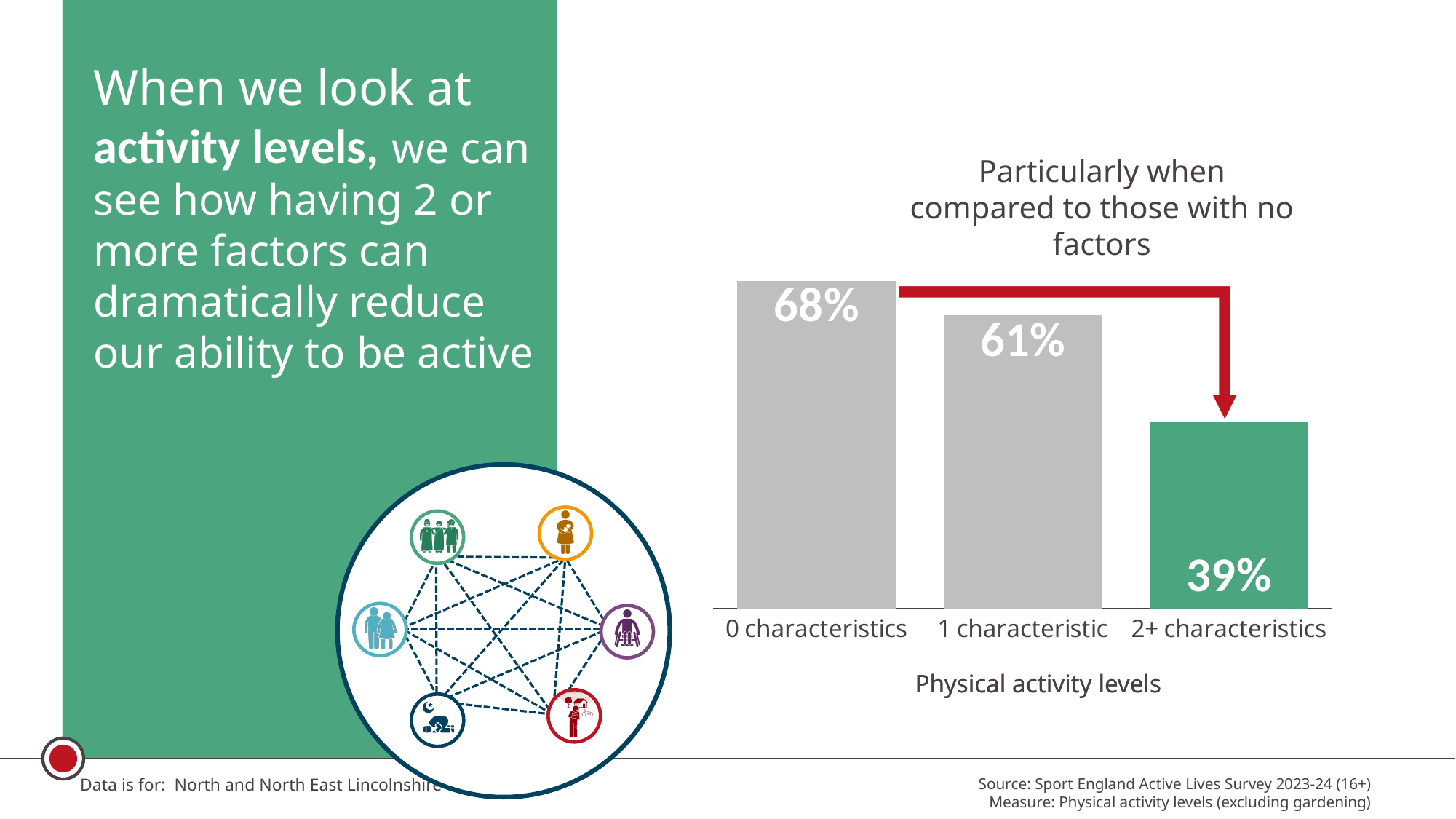
What kind of chart is shown on the slide? Bar chart What is the physical activity level for 2+ characteristics? 39% Which category has the highest physical activity level? 0 characteristics What is the difference in physical activity level between 0 characteristics and 1 characteristic? 7% Which bar in the chart is coloured green rather than grey? 2+ characteristics Which category has the lowest physical activity level? 2+ characteristics Which is larger, the value for 1 characteristic or the value for 2+ characteristics? 1 characteristic What is the physical activity level for 1 characteristic? 61% What is the difference in physical activity level between 0 characteristics and 2+ characteristics? 29% Do the values rise or fall as the number of characteristics increases? Fall How many categories are shown in the chart? 3 What is the physical activity level for 0 characteristics? 68%